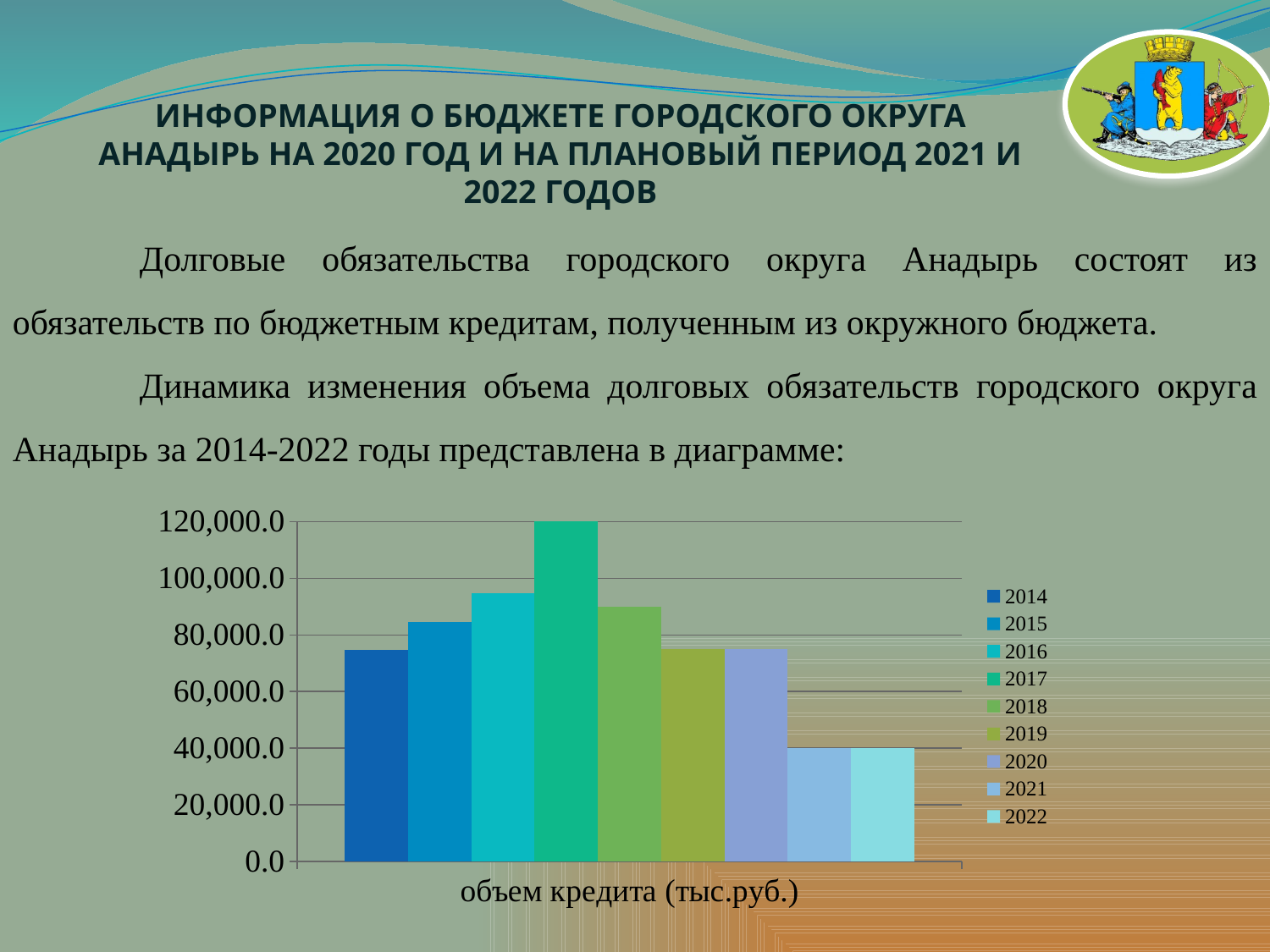
Which is larger, the value for 2015 or the value for 2021? 2015 Is the value for 2022 greater or less than 60,000.0? less Is the value for 2018 greater or less than 80,000.0? greater What kind of chart is shown on the slide? bar chart How many series does the chart legend list? 9 Is the value for 2016 greater or less than 100,000.0? less What is the value for 2021 in the chart? 40,000.0 Which is larger, the value for 2016 or the value for 2019? 2016 Which year has the highest value in the chart? 2017 What is the label shown on the horizontal axis of the chart? объем кредита (тыс.руб.)